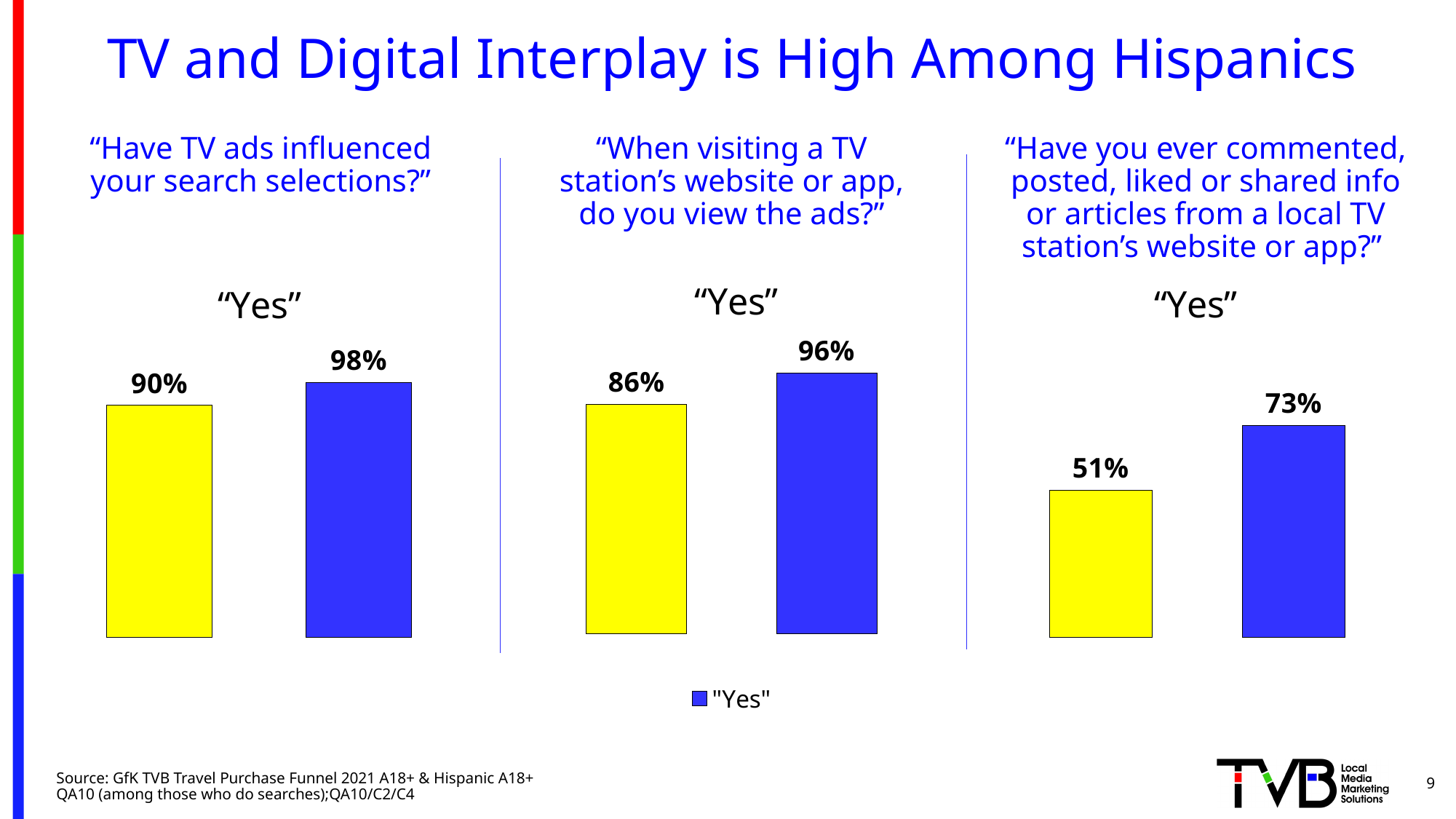
What kind of chart is used in each of the three panels on the slide? bar chart In the right chart ("Have you ever commented, posted, liked or shared info or articles from a local TV station's website or app?"), what value is shown on the blue bar? 73% Across all three charts, which chart has the lowest yellow-bar value? the right chart ("Have you ever commented, posted, liked or shared info or articles from a local TV station's website or app?") In the middle chart, what is the difference between the blue bar and the yellow bar? 10% In the left chart ("Have TV ads influenced your search selections?"), what value is shown on the yellow bar? 90% In the middle chart ("When visiting a TV station's website or app, do you view the ads?"), what value is shown on the blue bar? 96% In the left chart ("Have TV ads influenced your search selections?"), what value is shown on the blue bar? 98% In the right chart ("Have you ever commented, posted, liked or shared info or articles from a local TV station's website or app?"), what value is shown on the yellow bar? 51% In the right chart, what is the difference between the blue bar and the yellow bar? 22% How many entries does the legend at the bottom of the slide list? 1 In the middle chart ("When visiting a TV station's website or app, do you view the ads?"), what value is shown on the yellow bar? 86% In the left chart, which bar is higher, the yellow bar or the blue bar? the blue bar